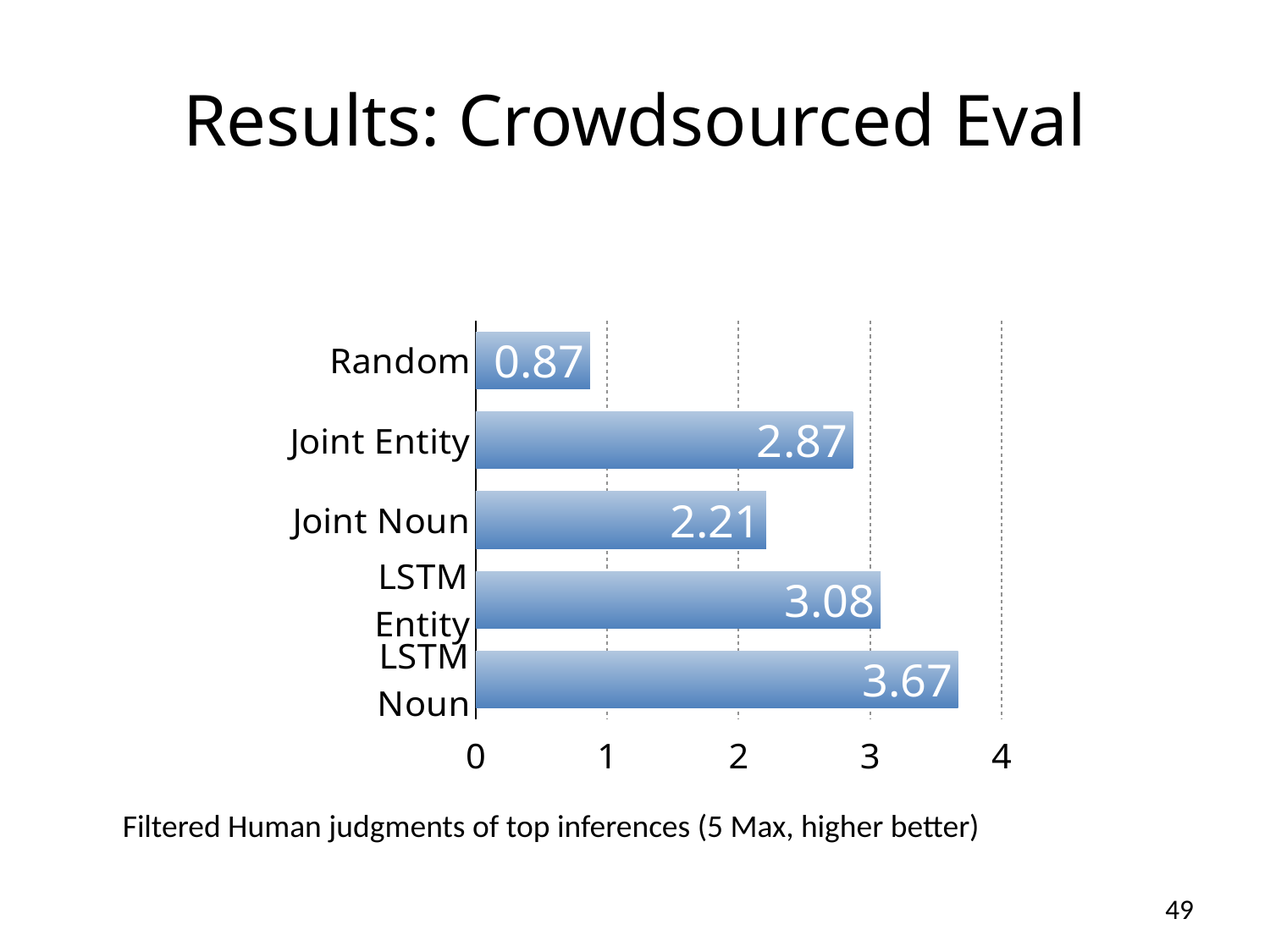
What is the value for Random? 0.87 What is the value for Joint Entity? 2.87 How many categories are shown in the chart? 5 What is the difference between the values for LSTM Noun and LSTM Entity? 0.59 Which category has the lowest value? Random What is the value for Joint Noun? 2.21 Is the value for LSTM Entity greater or less than 3? greater What is the title of the slide containing the chart? Results: Crowdsourced Eval What kind of chart is shown on the slide? bar chart What is the value for LSTM Noun? 3.67 Which category has the highest value? LSTM Noun Which is larger, the value for Joint Entity or the value for Joint Noun? Joint Entity